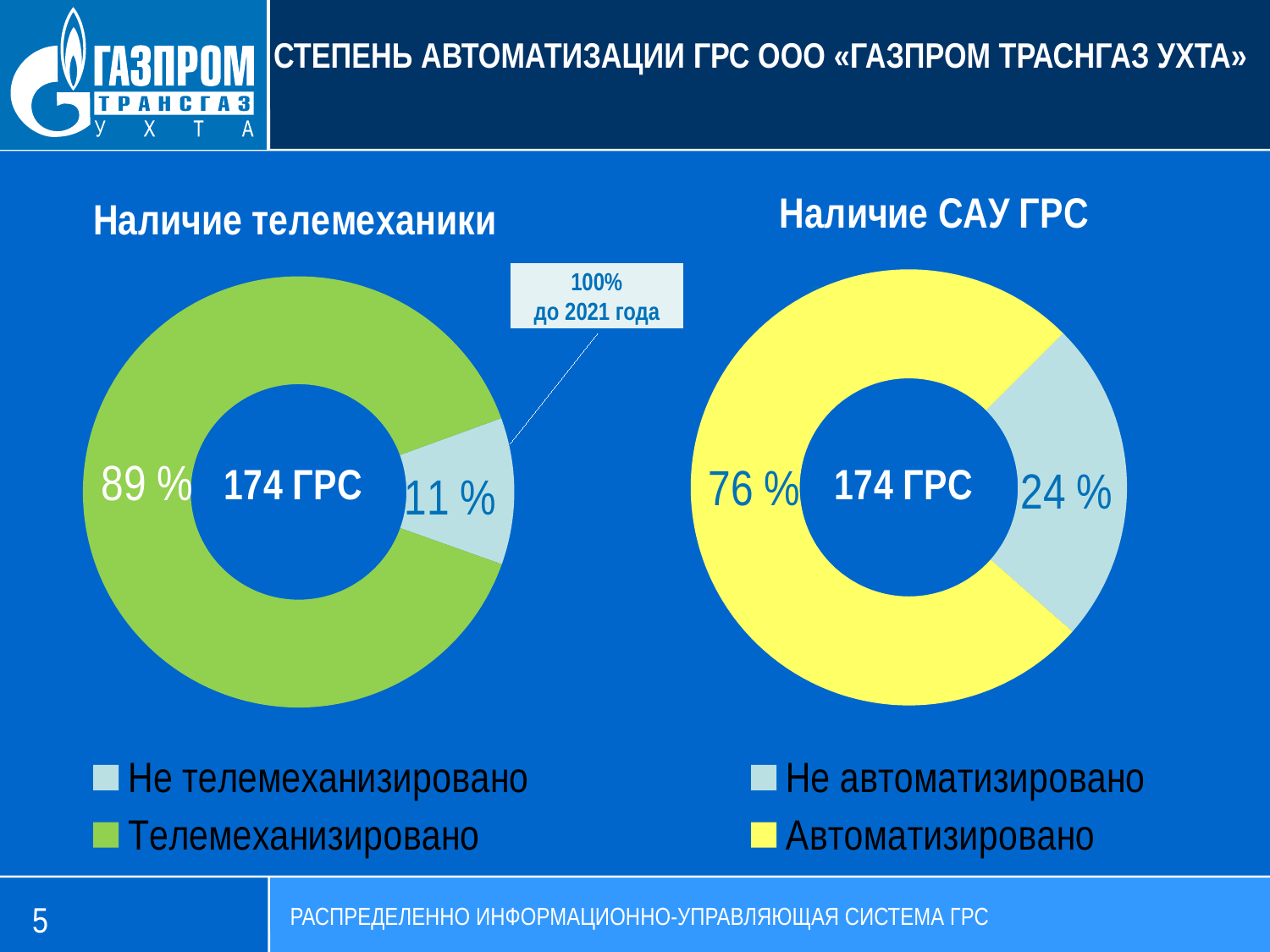
In the chart titled «Наличие САУ ГРС», what share is labelled for the «Не автоматизировано» slice? 24 % In the chart titled «Наличие телемеханики», which category has the largest slice? Телемеханизировано In the chart titled «Наличие телемеханики», what share is labelled for the «Телемеханизировано» slice? 89 % What kind of chart is the chart titled «Наличие САУ ГРС»? Doughnut (pie) chart In the chart titled «Наличие телемеханики», what share is labelled for the «Не телемеханизировано» slice? 11 % In the chart titled «Наличие САУ ГРС», which category has the smallest slice? Не автоматизировано What total number of ГРС is shown in the centre of the chart titled «Наличие САУ ГРС»? 174 ГРС In the chart titled «Наличие САУ ГРС», what is the difference in percentage points between the «Автоматизировано» and «Не автоматизировано» slices? 52 In the chart titled «Наличие САУ ГРС», what share is labelled for the «Автоматизировано» slice? 76 % In the chart titled «Наличие телемеханики», what is the difference in percentage points between the «Телемеханизировано» and «Не телемеханизировано» slices? 78 Which is larger: the «Не телемеханизировано» share in the left chart or the «Не автоматизировано» share in the right chart? Не автоматизировано How many categories does the legend of the chart titled «Наличие телемеханики» list? 2